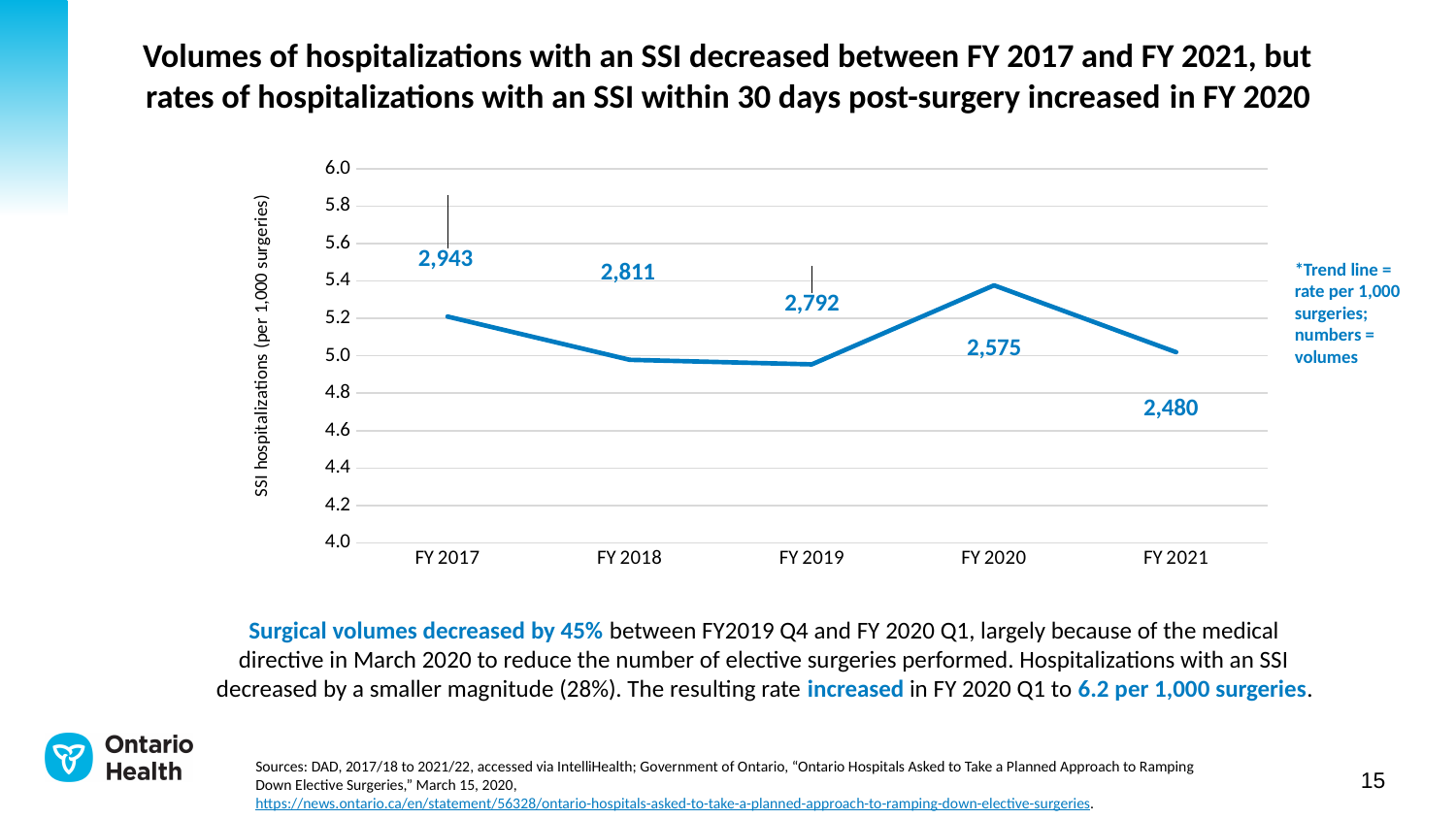
What is the volume of SSI hospitalizations shown for FY 2021? 2,480 What kind of chart is shown on the slide? line chart Which fiscal year has the lowest volume of SSI hospitalizations? FY 2021 How many fiscal years are plotted on the chart? 5 What is the difference between the SSI hospitalization volumes for FY 2017 and FY 2021? 463 Do the SSI hospitalization volumes rise or fall from FY 2017 to FY 2021? fall Is the rate per 1,000 surgeries for FY 2020 greater or less than 5.2? greater Which has the larger SSI hospitalization volume, FY 2018 or FY 2020? FY 2018 Which fiscal year has the highest volume of SSI hospitalizations? FY 2017 What is the volume of SSI hospitalizations shown for FY 2017? 2,943 Is the rate per 1,000 surgeries for FY 2021 greater or less than 5.2? less What is the volume of SSI hospitalizations shown for FY 2019? 2,792